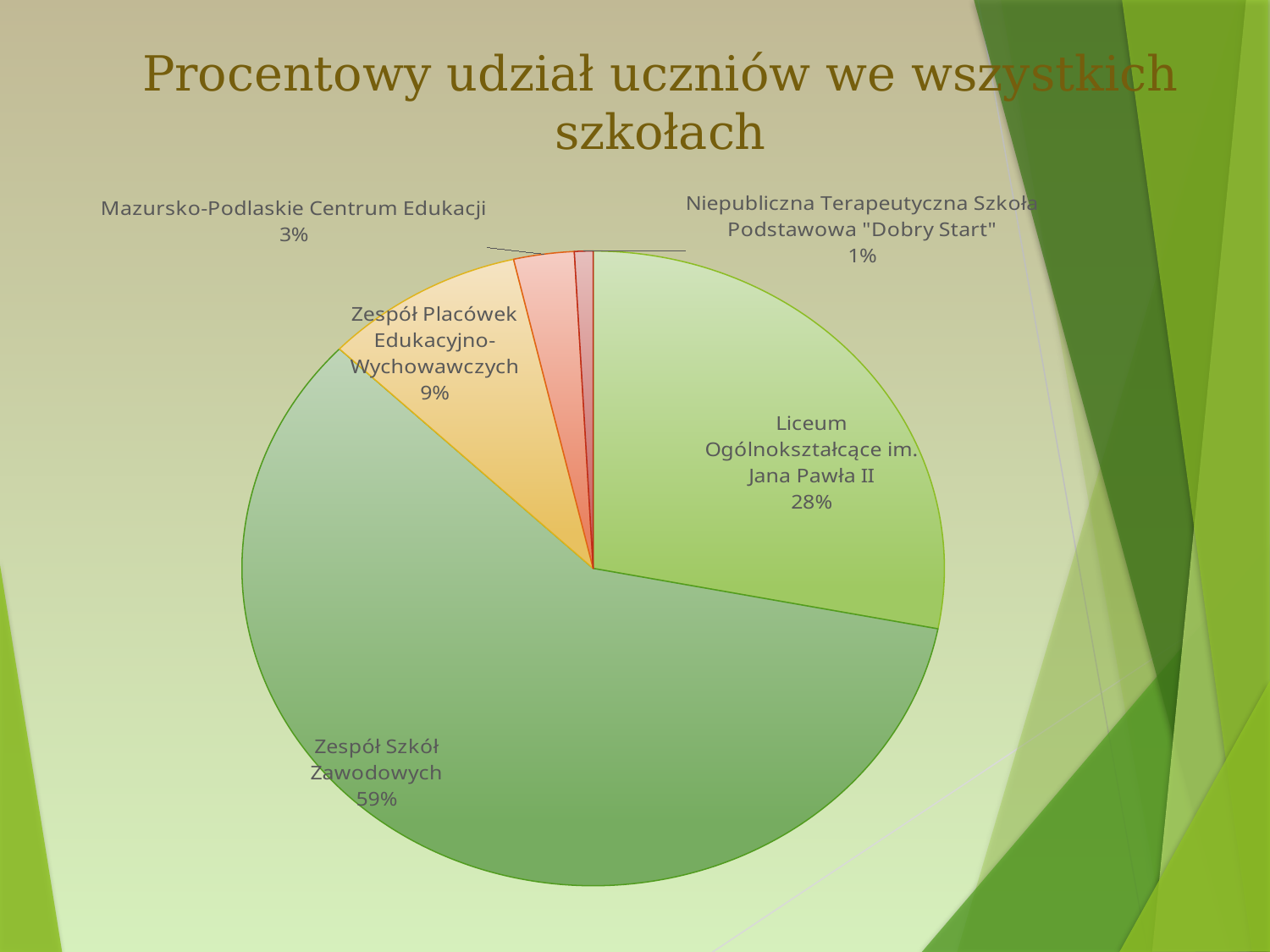
What share of the pie does Zespół Szkół Zawodowych have? 59% What is the difference in percentage points between Zespół Szkół Zawodowych and Liceum Ogólnokształcące im. Jana Pawła II? 31 What is the title of the chart? Procentowy udział uczniów we wszystkich szkołach What share of the pie does Liceum Ogólnokształcące im. Jana Pawła II have? 28% Which school has the smallest slice of the pie? Niepubliczna Terapeutyczna Szkoła Podstawowa "Dobry Start" What share of the pie does Mazursko-Podlaskie Centrum Edukacji have? 3% Which is larger: the share for Zespół Placówek Edukacyjno-Wychowawczych or the share for Mazursko-Podlaskie Centrum Edukacji? Zespół Placówek Edukacyjno-Wychowawczych What type of chart is shown on the slide? pie chart How many slices does the pie chart have? 5 Which school has the largest slice of the pie? Zespół Szkół Zawodowych